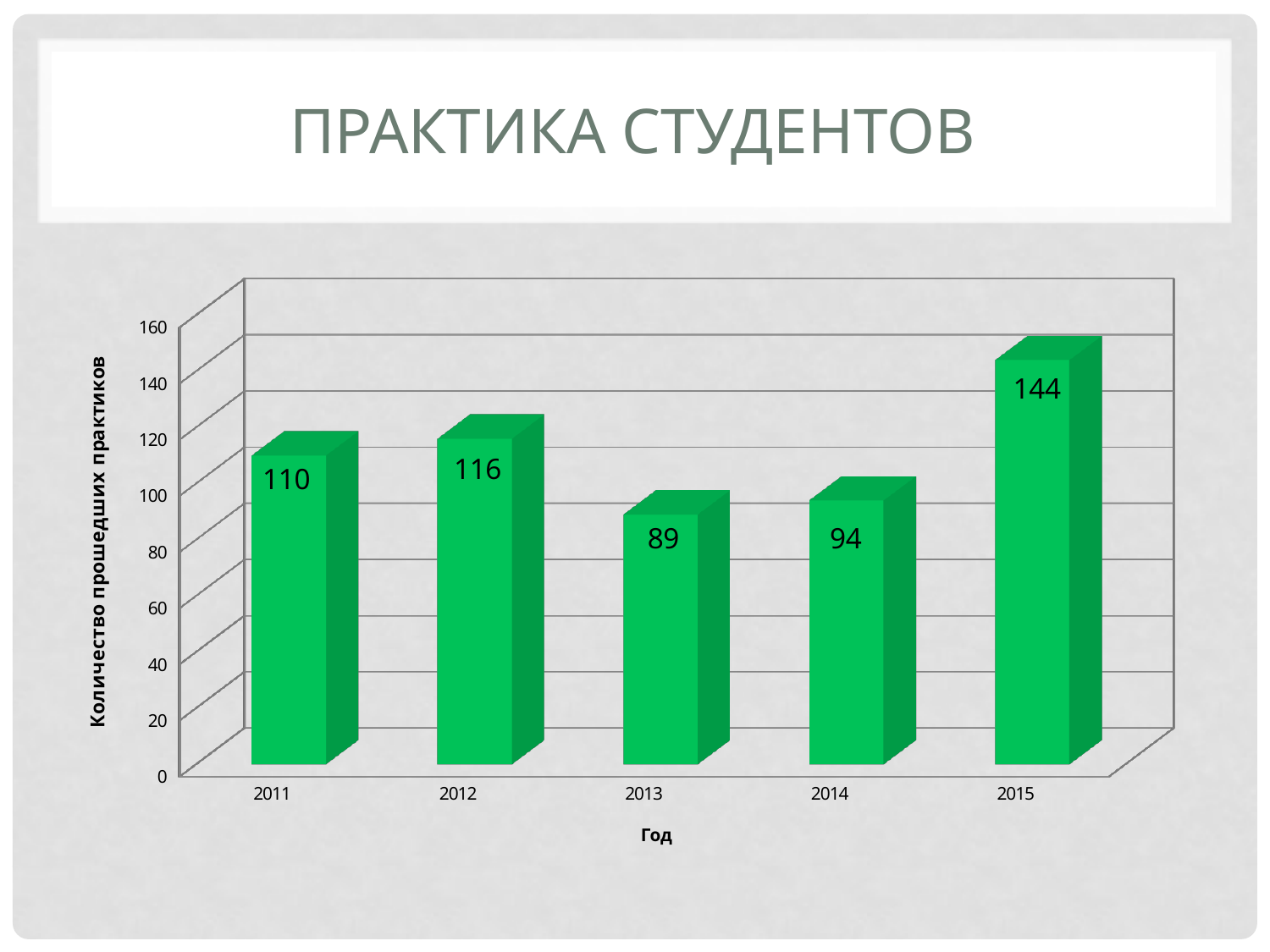
What kind of chart is shown on the slide? bar chart What is the value for 2011? 110 Which year has the lowest value? 2013 Which is larger, the value for 2012 or the value for 2014? 2012 What is the value for 2013? 89 Is the value for 2014 greater or less than 100? less What is the difference between the values for 2012 and 2011? 6 What is the difference between the values for 2015 and 2013? 55 What is the value for 2015? 144 Which year has the highest value? 2015 How many years are shown on the x axis? 5 What is the title of the slide? ПРАКТИКА СТУДЕНТОВ